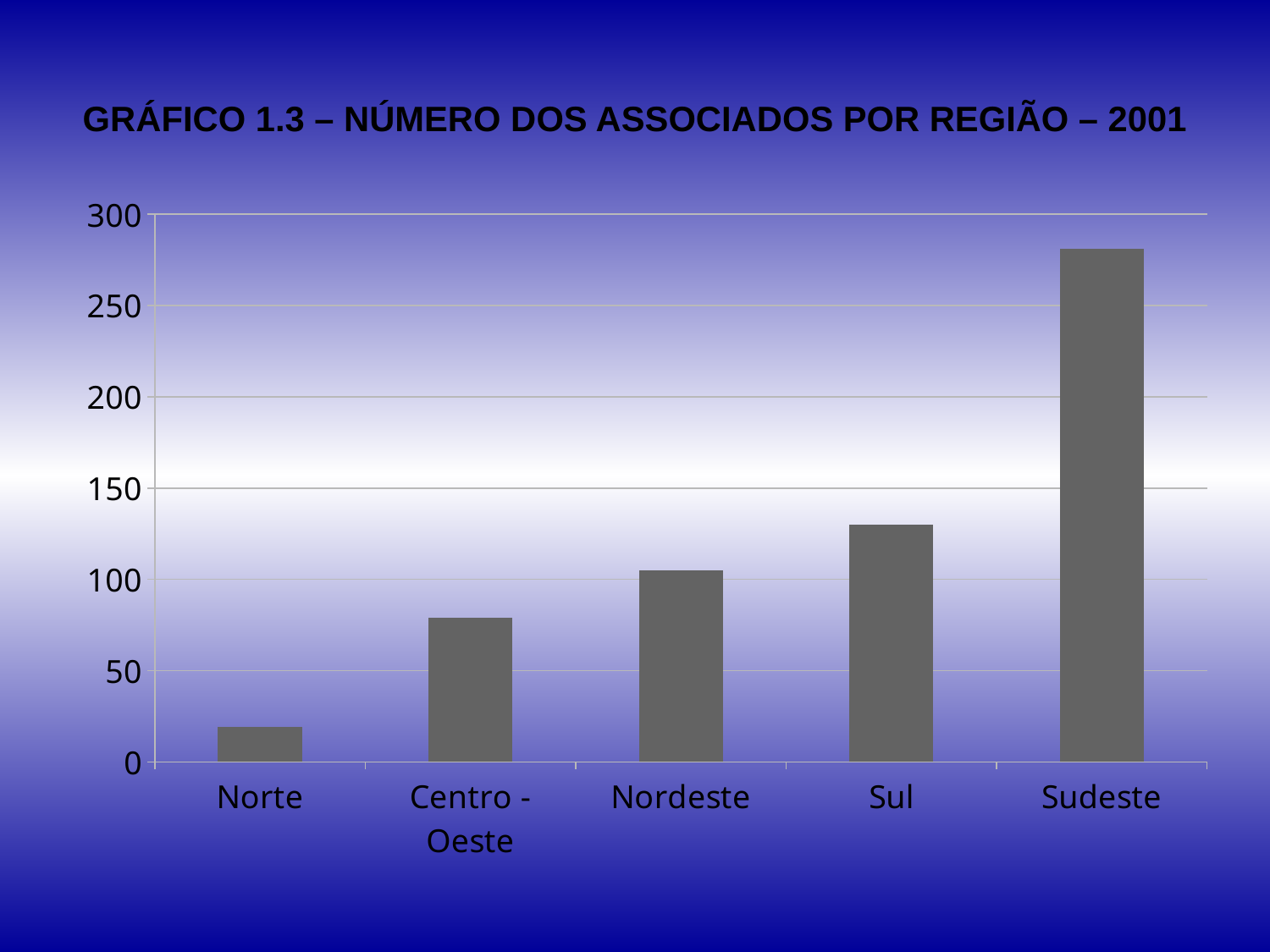
Is the value for Sul greater or less than 150? less Do the values rise or fall moving from left to right along the x axis? rise Which has more associates, Sul or Nordeste? Sul Is the value for Sudeste greater or less than 250? greater What kind of chart is shown on the slide? bar chart Is the value for Norte greater or less than 50? less Which region has the highest number of associates? Sudeste What is the title of the chart? GRÁFICO 1.3 – NÚMERO DOS ASSOCIADOS POR REGIÃO – 2001 Which region has the lowest number of associates? Norte How many regions are shown on the x axis of the chart? 5